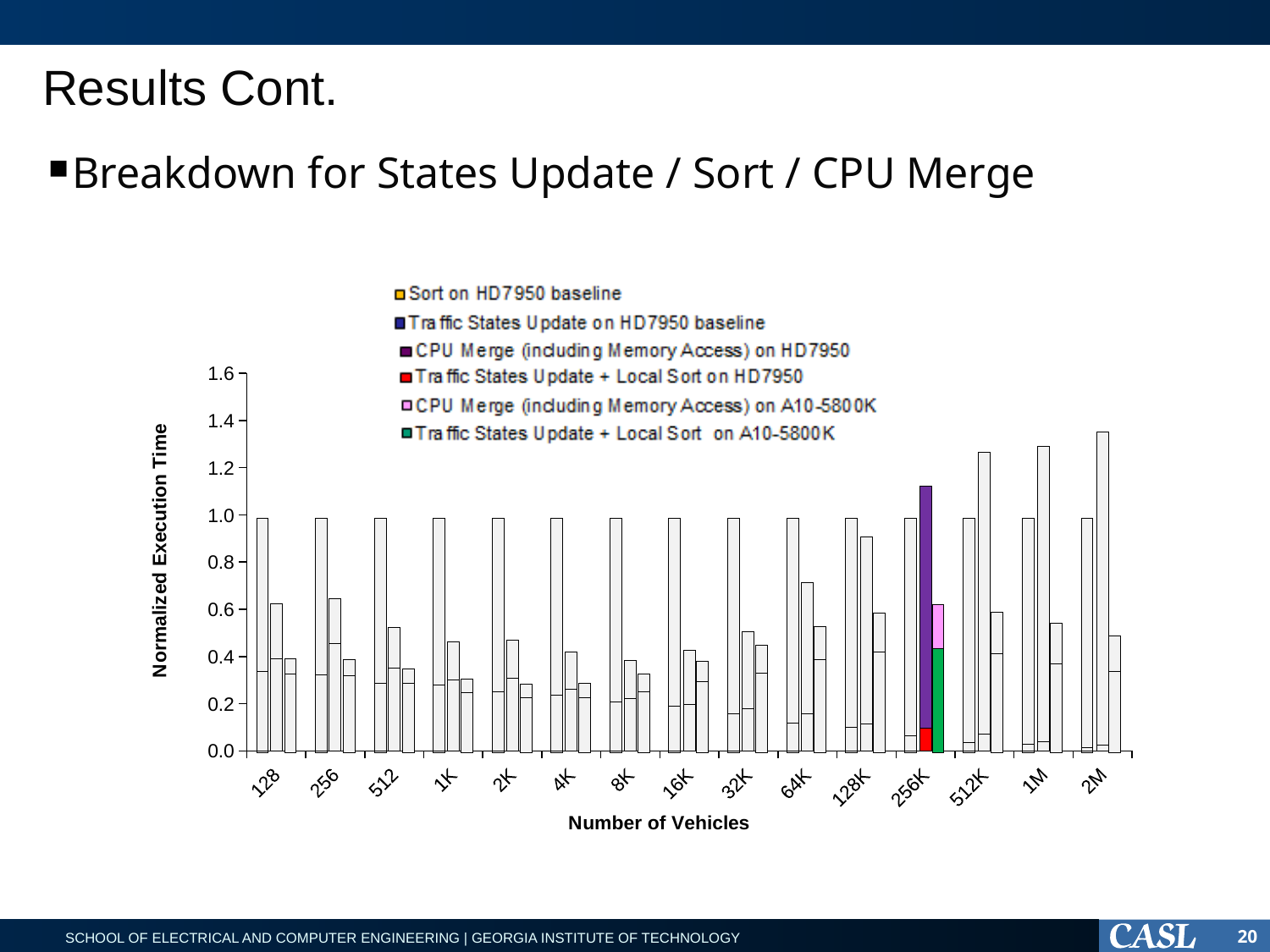
Which Number of Vehicles category contains the tallest bar on the chart? 2M How many categories are shown on the x axis (Number of Vehicles)? 15 What kind of chart is shown on the slide? Stacked bar chart Is the second (HD7950) bar in the 128K group greater or less than 0.8? greater Is the purple-topped bar in the 256K group greater or less than 1.0? greater What is the title of the y axis? Normalized Execution Time In the 2M group, which is taller: the second (HD7950) bar or the third (A10-5800K) bar? The second (HD7950) bar Is the second (HD7950) bar in the 128 group greater or less than 0.8? less How many series does the legend list? 6 From 64K to 2M, does the height of the second (HD7950) bar in each group rise or fall? Rise Which colour represents 'Traffic States Update + Local Sort on A10-5800K' in the legend? Green